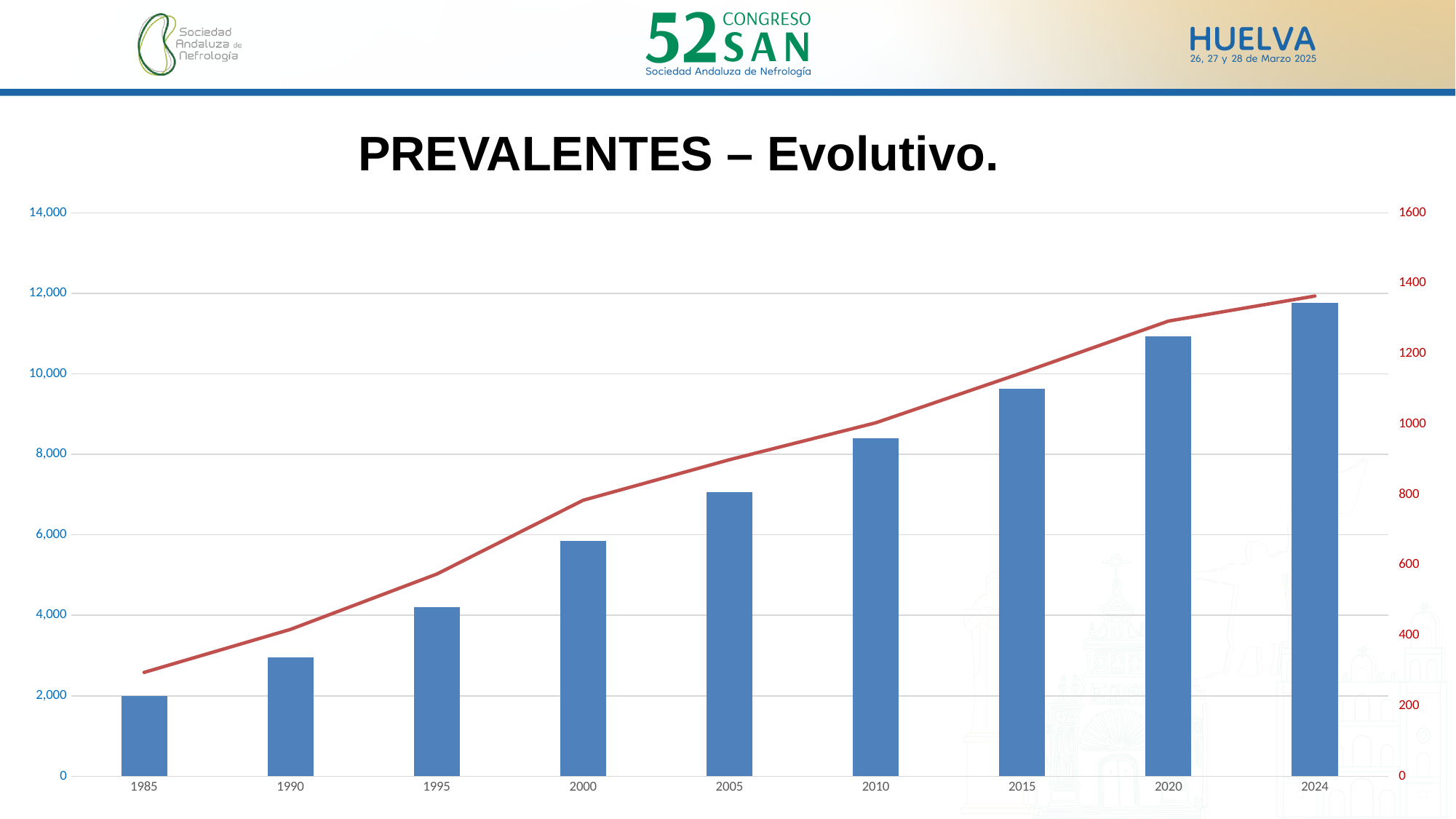
Is the bar value for 2005 greater or less than 6,000? greater Which bar is taller, 2015 or 2020? 2020 What is the title of the chart? PREVALENTES – Evolutivo. Is the bar value for 1990 greater or less than 4,000? less Do the bar values rise or fall from 1985 to 2024? rise Which year has the tallest bar? 2024 Is the bar value for 2010 greater or less than 8,000? greater What kind of chart is shown on the slide? combination bar and line chart How many years are shown along the x axis of the chart? 9 What is the highest value shown on the left vertical axis? 14,000 Which year has the shortest bar? 1985